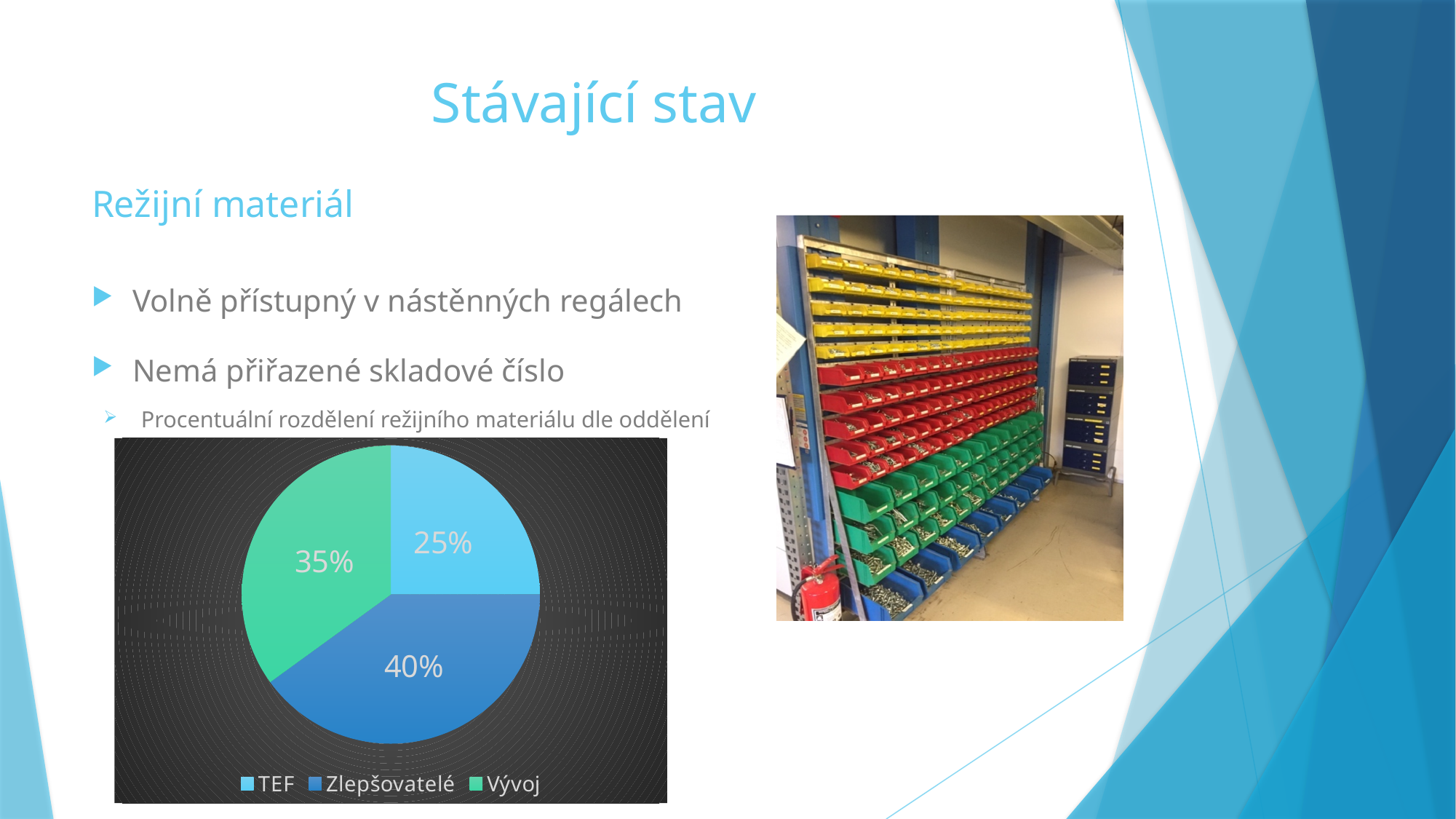
What percentage of the pie chart is Zlepšovatelé? 40% Which category has the smallest share of the pie chart? TEF What percentage of the pie chart is TEF? 25% What is the difference in percentage points between Vývoj and TEF? 10% Which colour represents Vývoj in the pie chart? green How many entries does the legend of the pie chart list? 3 Which category has the largest share of the pie chart? Zlepšovatelé What is the difference in percentage points between Zlepšovatelé and TEF? 15% Which has a larger share, Vývoj or TEF? Vývoj What kind of chart is shown on the slide? pie chart How many categories does the pie chart show? 3 What percentage of the pie chart is Vývoj? 35%